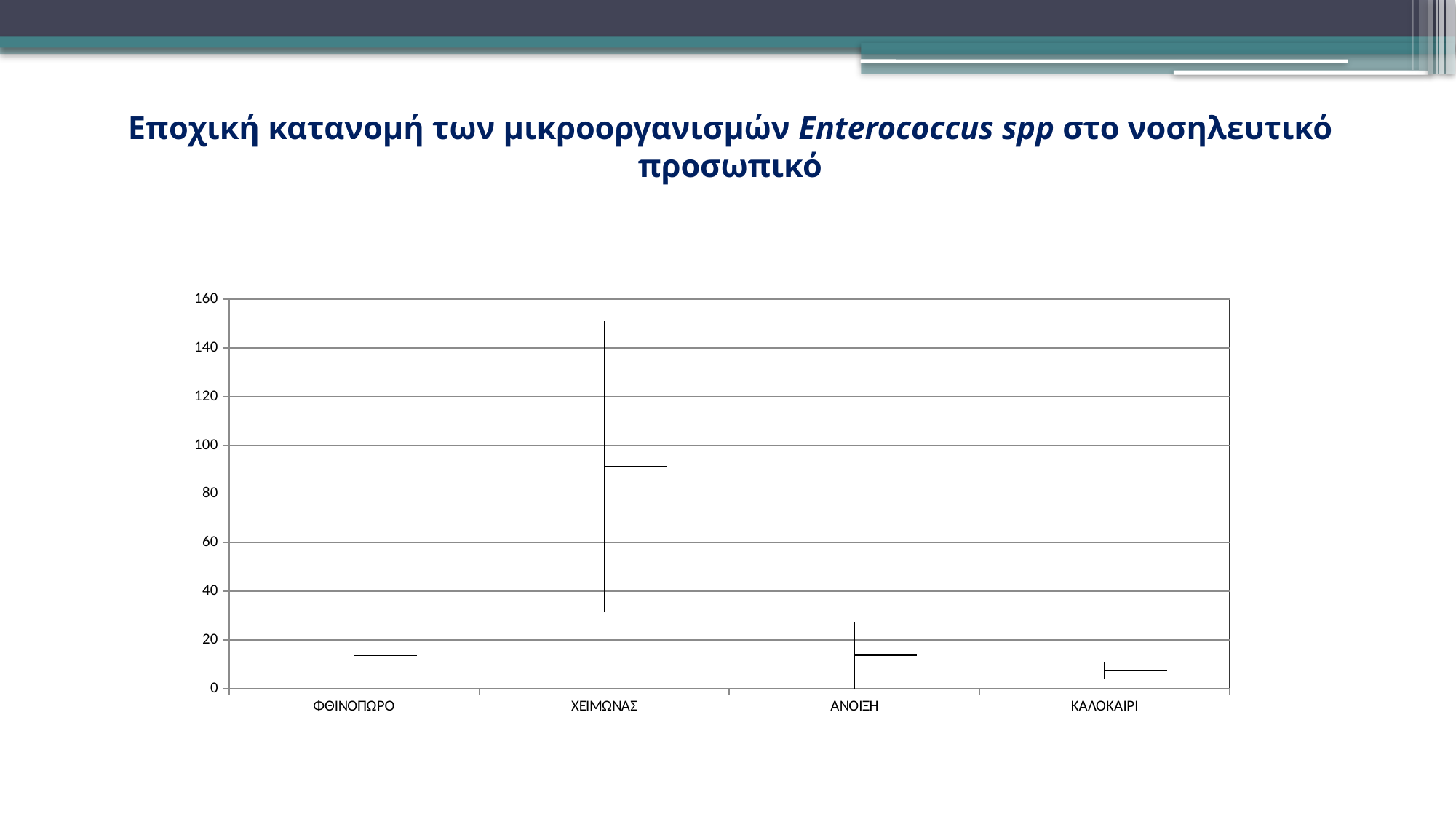
Is the horizontal marker value for ΦΘΙΝΟΠΩΡΟ greater or less than 40? less Is the horizontal marker value for ΧΕΙΜΩΝΑΣ greater or less than 100? less Which has a larger horizontal marker value, ΑΝΟΙΞΗ or ΚΑΛΟΚΑΙΡΙ? ΑΝΟΙΞΗ Is the horizontal marker value for ΚΑΛΟΚΑΙΡΙ greater or less than 20? less Which microorganism is named in the slide title? Enterococcus spp How many seasons (categories) are shown on the x axis of the chart? 4 Which season has the lowest horizontal marker value in the chart? ΚΑΛΟΚΑΙΡΙ What is the maximum value shown on the y axis of the chart? 160 Which has a larger horizontal marker value, ΧΕΙΜΩΝΑΣ or ΑΝΟΙΞΗ? ΧΕΙΜΩΝΑΣ Which season has the highest values in the chart? ΧΕΙΜΩΝΑΣ